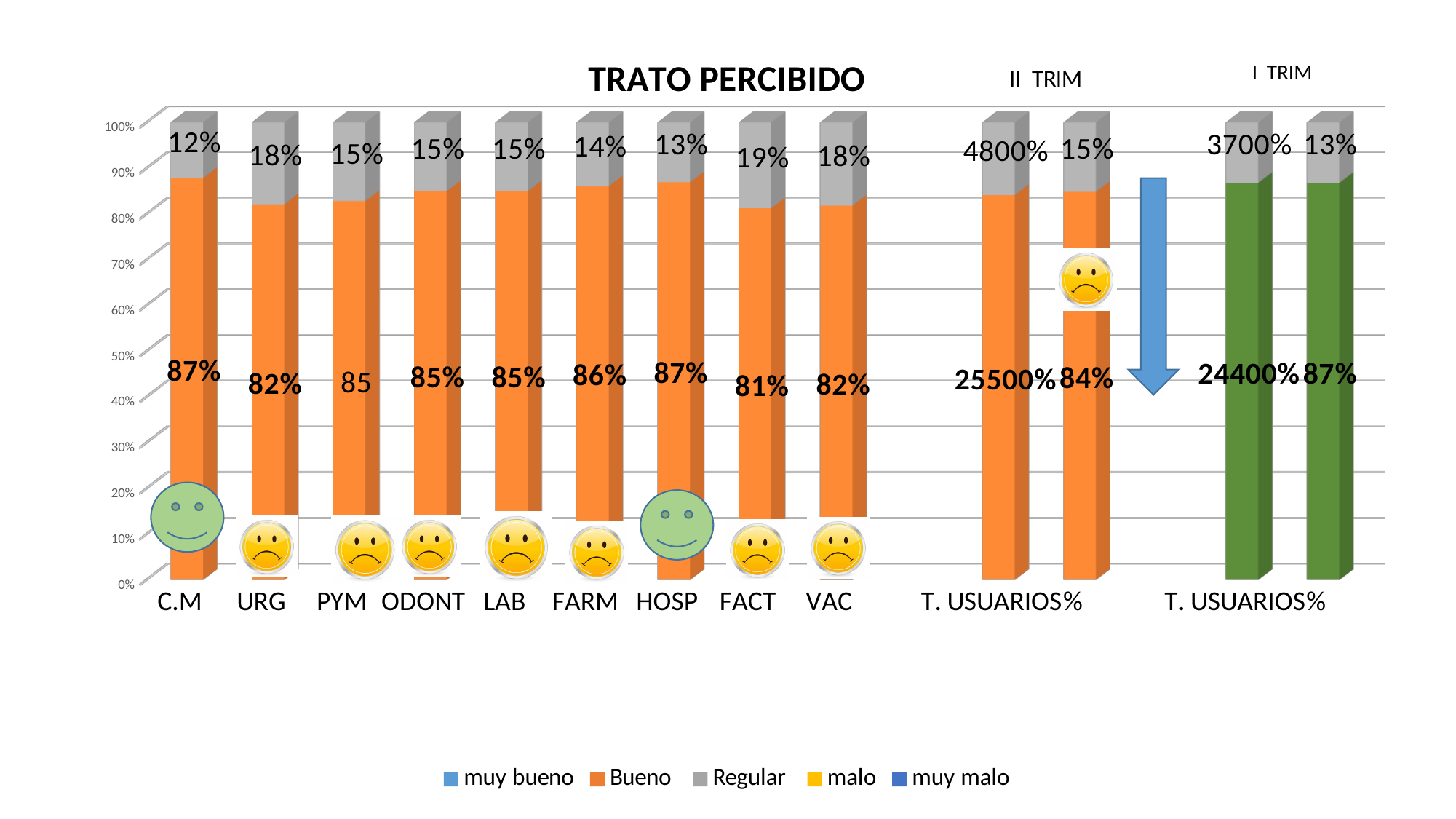
Which department category has the highest Regular value? FACT Which department category has the lowest Regular value? C.M What is the title of the chart? TRATO PERCIBIDO What kind of chart is shown on the slide? Stacked bar chart What is the difference between the Regular value for FACT and the Regular value for C.M? 7% What is the Regular value for HOSP? 13% How many series does the legend list? 5 What is the Bueno value for C.M? 87% What is the Bueno value for FARM? 86% What is the Regular value for FACT? 19% Which department category has the lowest Bueno value? FACT Which has a larger Bueno value, URG or FARM? FARM